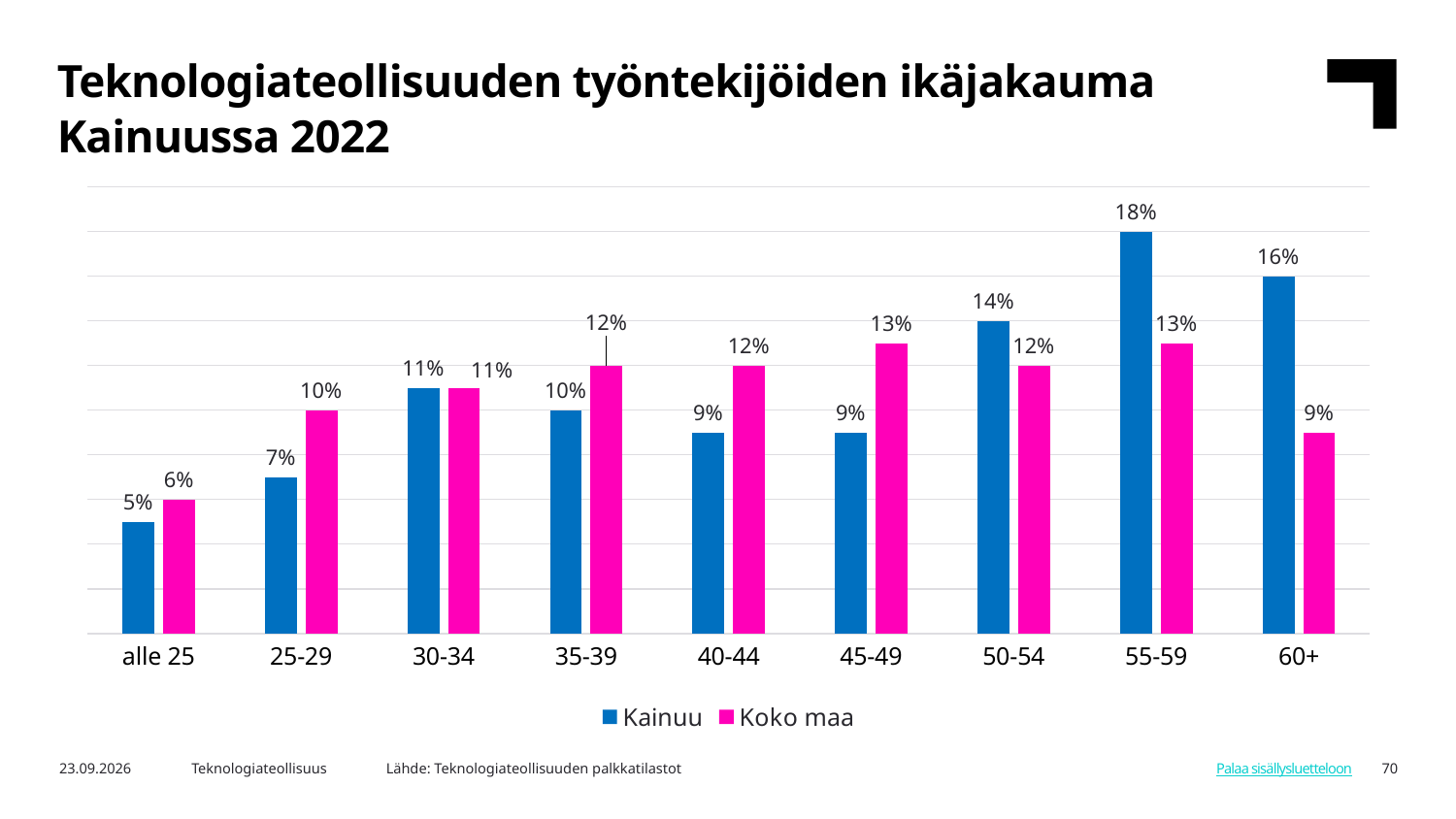
How many age groups are shown on the x axis? 9 What is the value for Koko maa in the 45-49 age group? 13% Which is larger in the 25-29 age group, Kainuu or Koko maa? Koko maa Which age group has the lowest value for Koko maa? alle 25 How many series does the legend list? 2 Which age group has the highest value for Kainuu? 55-59 Which is larger in the 50-54 age group, Kainuu or Koko maa? Kainuu Which series is shown in pink? Koko maa What is the value for Kainuu in the 55-59 age group? 18% What is the difference between Kainuu and Koko maa in the 60+ age group? 7 percentage points What kind of chart is shown on the slide? Bar chart What is the value for Kainuu in the alle 25 age group? 5%